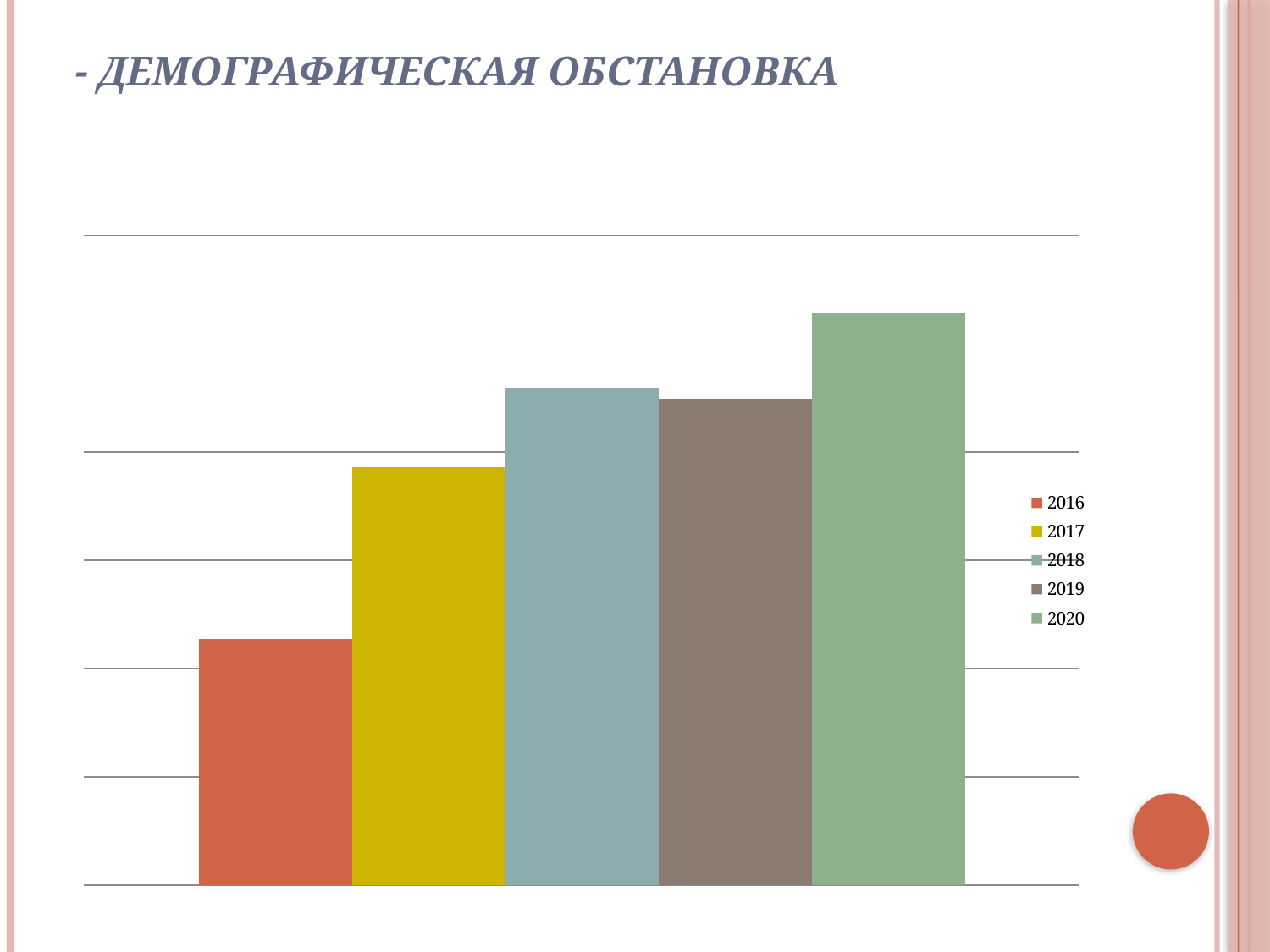
How many entries does the chart legend list? 5 Which is larger, the bar for 2019 or the bar for 2016? 2019 Do the bars generally rise or fall from 2016 to 2020? rise Which year is shown in the legend with a green colour? 2020 What kind of chart is shown on the slide? bar chart Which is larger, the bar for 2017 or the bar for 2016? 2017 Which is larger, the bar for 2018 or the bar for 2017? 2018 Which year has the highest bar in the chart? 2020 What is the title of the slide containing the chart? - ДЕМОГРАФИЧЕСКАЯ ОБСТАНОВКА How many bars are plotted in the chart? 5 Which year has the lowest bar in the chart? 2016